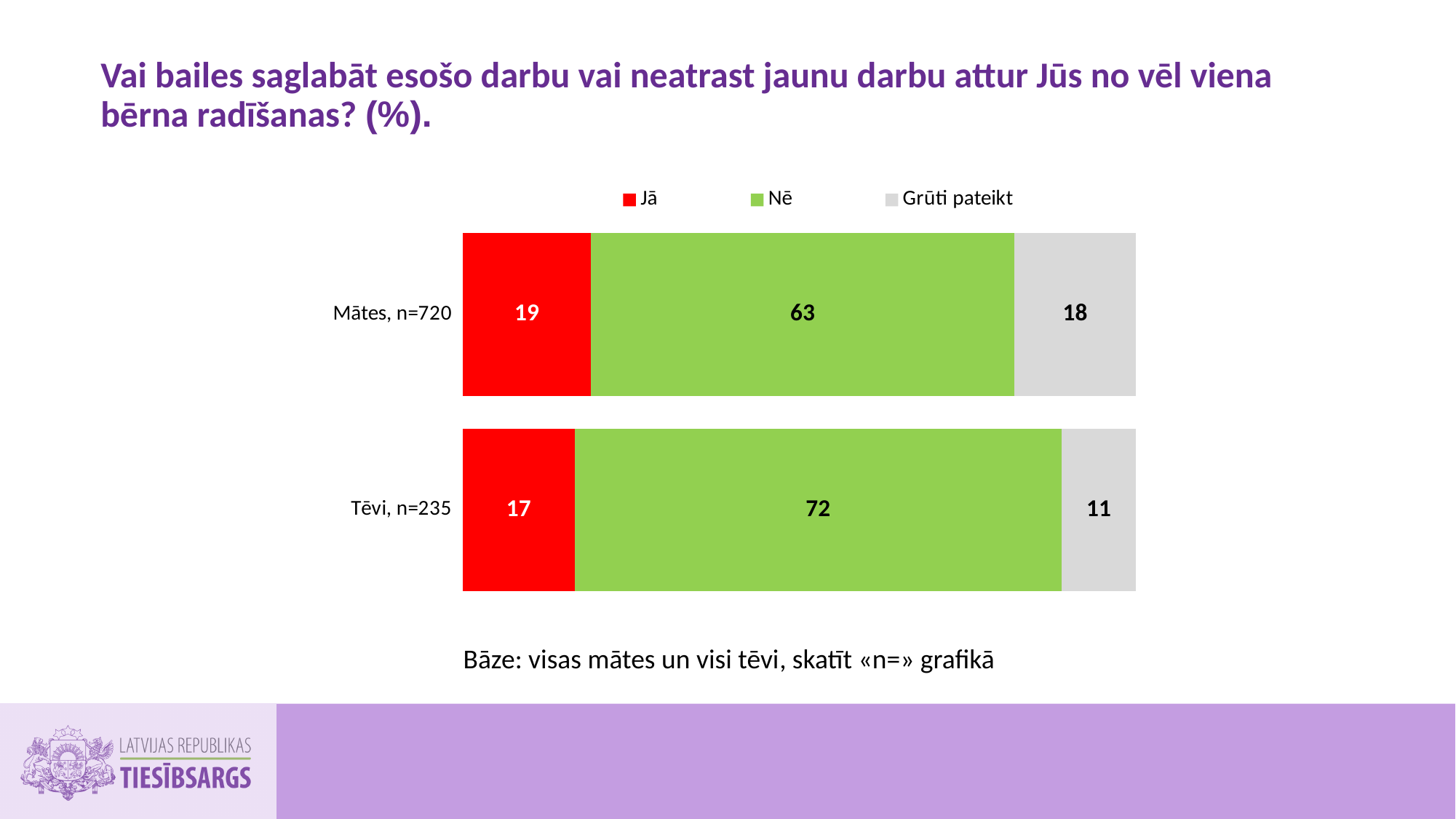
Is the "Jā" value larger for Mātes, n=720 or for Tēvi, n=235? Mātes, n=720 What is the difference between the "Nē" values for Tēvi, n=235 and Mātes, n=720? 9 What is the value for "Grūti pateikt" for Tēvi, n=235? 11 What is the value for "Jā" for Mātes, n=720? 19 What is the value for "Grūti pateikt" for Mātes, n=720? 18 Which category has the lower value for "Grūti pateikt"? Tēvi, n=235 How many series does the legend list? 3 What kind of chart is shown on the slide? Stacked bar chart What colour represents the "Nē" series in the chart? Green How many categories are shown in the chart? 2 Which category has the higher value for "Nē"? Tēvi, n=235 What is the value for "Nē" for Tēvi, n=235? 72